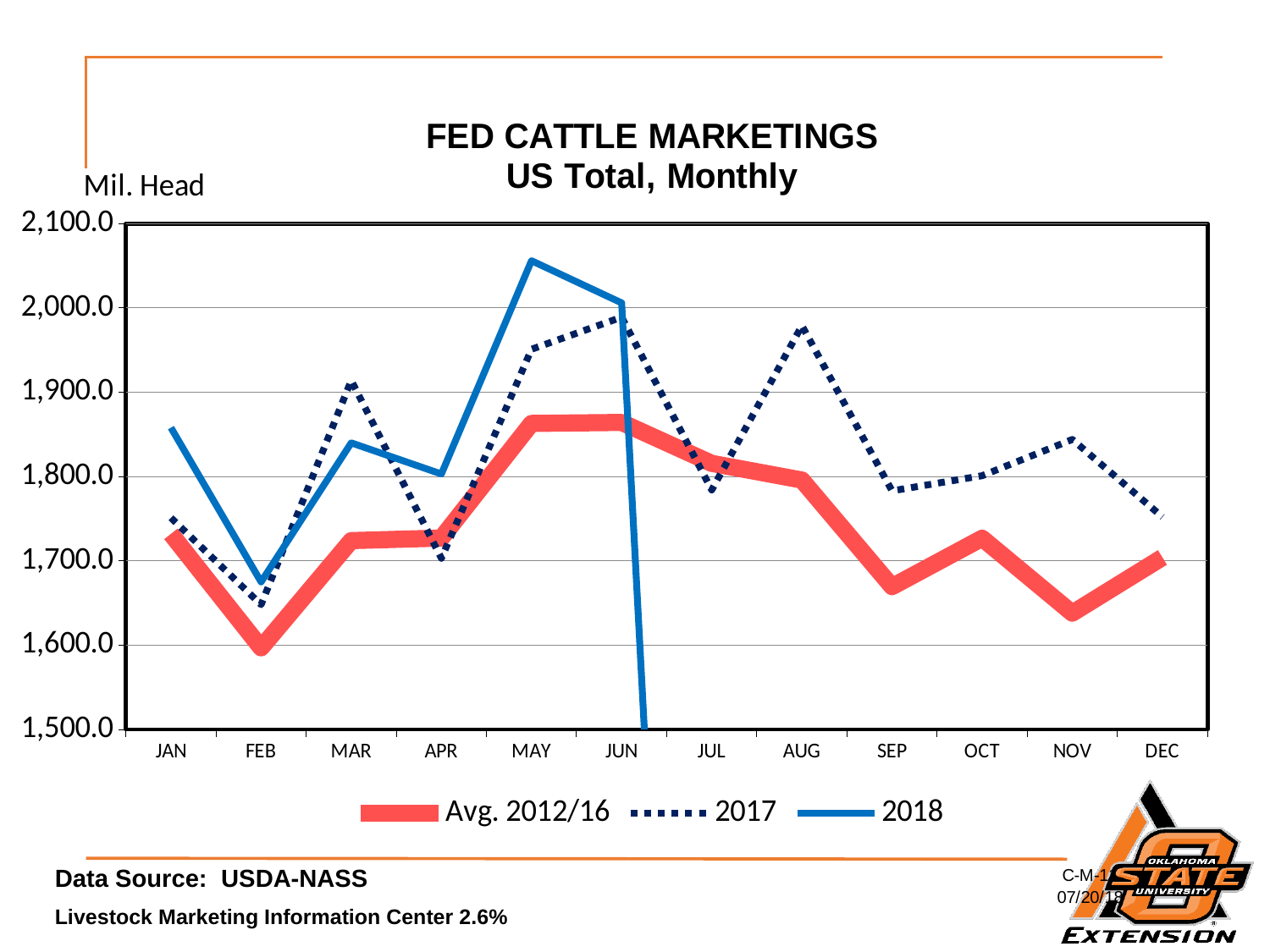
In which month is the 2017 series at its lowest value? FEB In which month is the Avg. 2012/16 series at its lowest value? FEB What unit label is shown above the y axis? Mil. Head In which month does the 2018 series reach its highest value? MAY Does the Avg. 2012/16 series rise or fall from JUN to SEP? fall Is the Avg. 2012/16 value for SEP greater or less than 1,700.0? less How many series does the legend list? 3 How many months are shown along the x axis? 12 Is the 2018 value for MAY greater or less than 2,000.0? greater Which series has the higher value in MAY, 2017 or 2018? 2018 What kind of chart is shown on the slide? line chart Is the 2017 value for AUG greater or less than 2,000.0? less